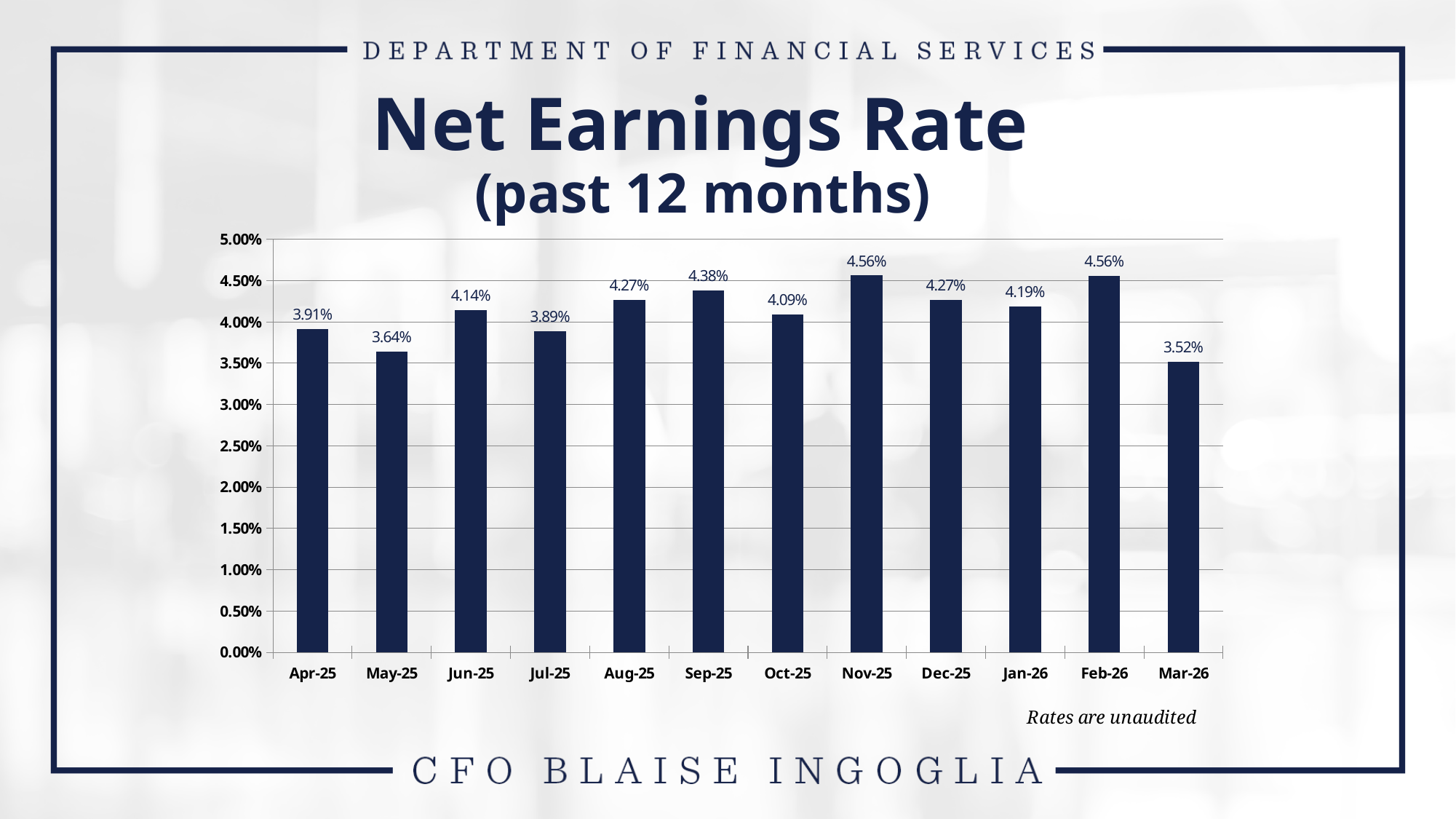
What kind of chart is shown on the slide? Bar chart What is the difference between the net earnings rate for Nov-25 and Mar-26? 1.04 percentage points What is the net earnings rate for Jan-26? 4.19% How many months are shown on the chart? 12 What is the net earnings rate for May-25? 3.64% What is the net earnings rate for Nov-25? 4.56% Which is larger, the net earnings rate for Aug-25 or Oct-25? Aug-25 Which month has the lowest net earnings rate? Mar-26 What is the highest net earnings rate shown on the chart? 4.56% What is the difference between the net earnings rate for Jun-25 and May-25? 0.50 percentage points What is the net earnings rate for Sep-25? 4.38% Is the net earnings rate for Jul-25 greater or less than 4.00%? less